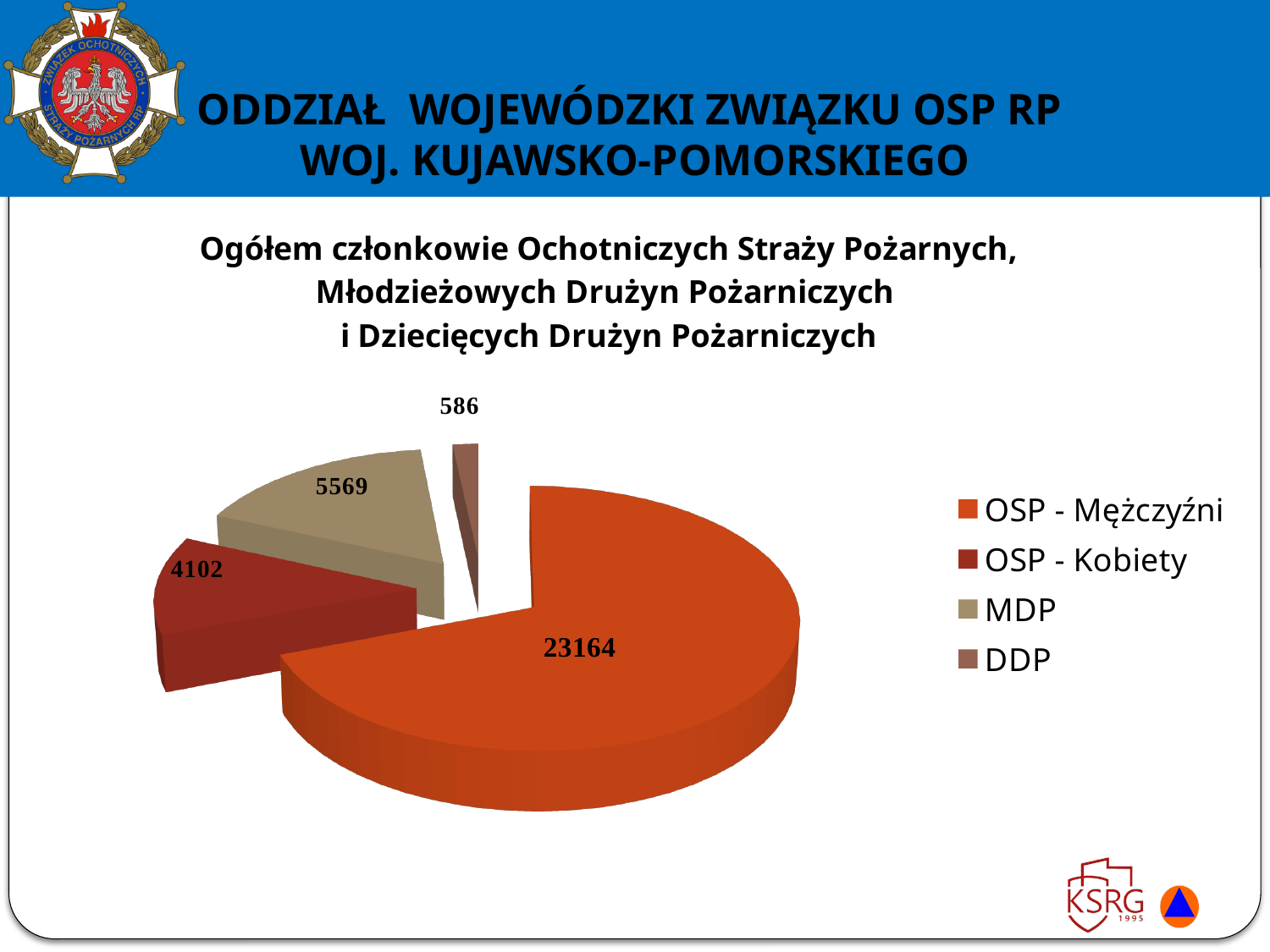
What is the value for MDP? 5569 What kind of chart is shown on the slide? Pie chart Which category has the smallest slice of the pie? DDP What is the difference between the values for OSP - Mężczyźni and MDP? 17595 What is the value for OSP - Kobiety? 4102 What is the value for DDP? 586 What is the total of all four slices in the pie chart? 33421 Which is larger, the value for MDP or the value for OSP - Kobiety? MDP What is the value for OSP - Mężczyźni? 23164 How many categories does the pie chart show? 4 Which category has the largest slice of the pie? OSP - Mężczyźni What is the difference between the values for MDP and OSP - Kobiety? 1467